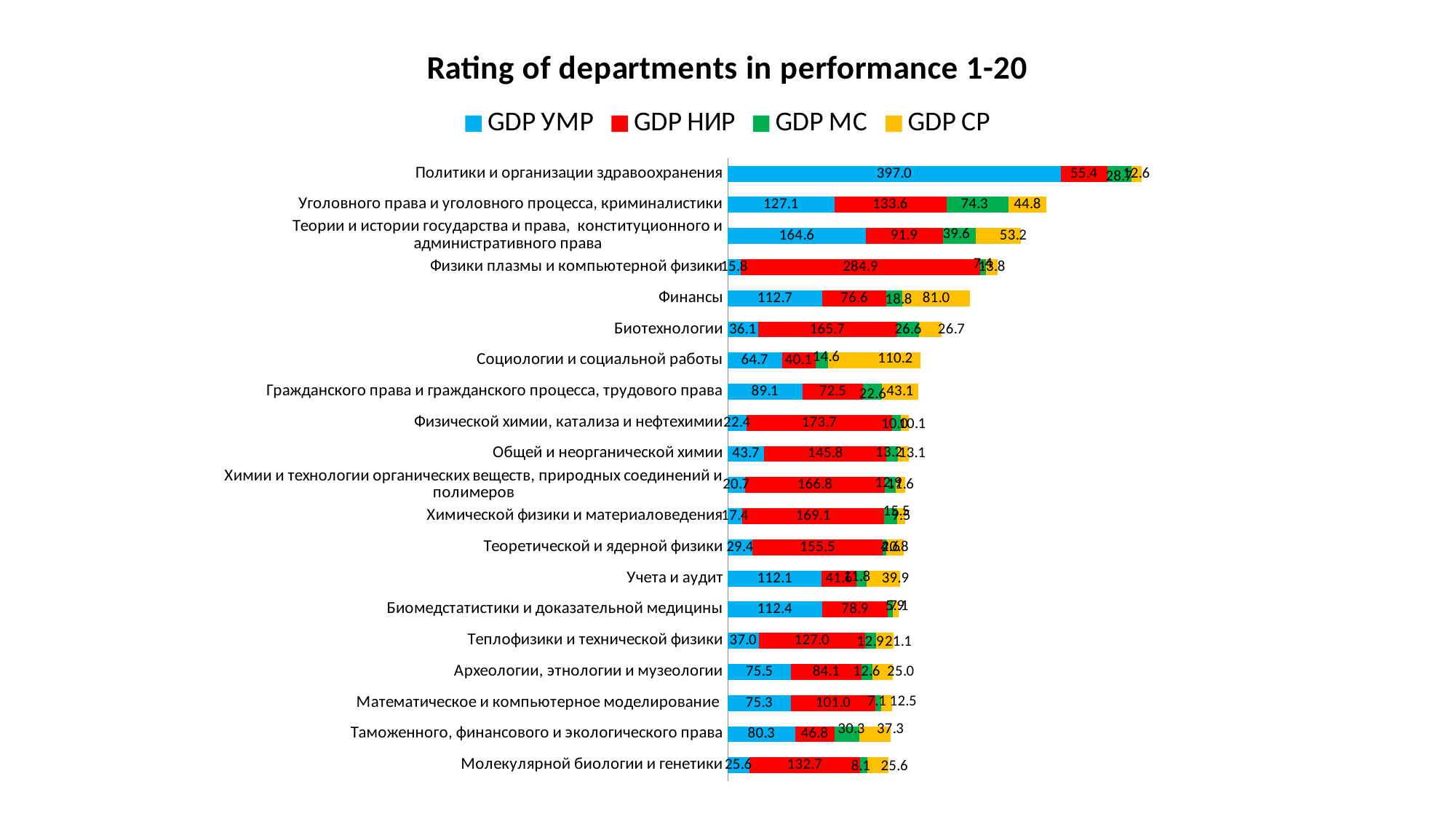
What is the total of the stacked bar for Уголовного права и уголовного процесса, криминалистики? 379.8 Which department has the highest GDP НИР value? Физики плазмы и компьютерной физики What kind of chart is shown on the slide? Stacked bar chart What is the GDP МС value for Уголовного права и уголовного процесса, криминалистики? 74.3 How many series does the legend list? 4 What is the GDP УМР value for Политики и организации здравоохранения? 397.0 What is the GDP СР value for Финансы? 81.0 What is the difference between GDP УМР and GDP НИР for Теории и истории государства и права, конституционного и административного права? 72.7 Which department has the highest GDP УМР value? Политики и организации здравоохранения How many departments are plotted in the chart? 20 What is the GDP НИР value for Физики плазмы и компьютерной физики? 284.9 For Финансы, which is larger: GDP УМР or GDP СР? GDP УМР